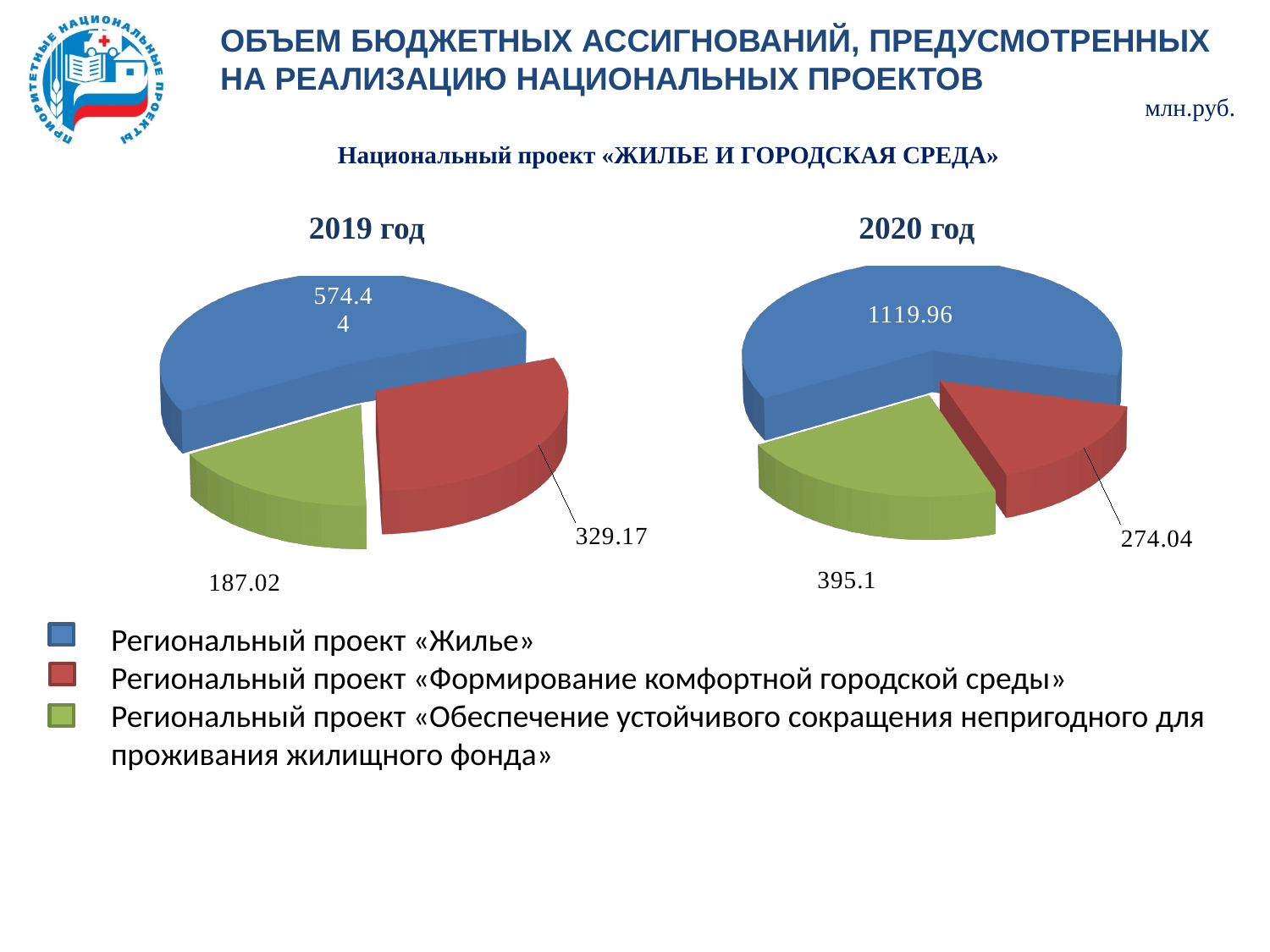
In the 2020 год pie chart, what is the value for Региональный проект «Жилье»? 1119.96 In the 2020 год pie chart, what is the value for Региональный проект «Формирование комфортной городской среды»? 274.04 In the 2020 год pie chart, which regional project has the largest value? Региональный проект «Жилье» How many slices does the 2020 год pie chart have? 3 In the 2019 год pie chart, what is the difference between the value for «Жилье» and the value for «Формирование комфортной городской среды»? 245.27 What kind of chart is used for the 2019 год and 2020 год data on the slide? Pie chart In the 2020 год pie chart, what is the value for Региональный проект «Обеспечение устойчивого сокращения непригодного для проживания жилищного фонда»? 395.1 In the 2019 год pie chart, which regional project has the smallest value? Региональный проект «Обеспечение устойчивого сокращения непригодного для проживания жилищного фонда» In the 2019 год pie chart, what is the value for Региональный проект «Обеспечение устойчивого сокращения непригодного для проживания жилищного фонда»? 187.02 In the 2019 год pie chart, what is the value for Региональный проект «Жилье»? 574.44 In the 2019 год pie chart, what is the value for Региональный проект «Формирование комфортной городской среды»? 329.17 In the 2020 год pie chart, which is larger: the value for «Формирование комфортной городской среды» or the value for «Обеспечение устойчивого сокращения непригодного для проживания жилищного фонда»? Региональный проект «Обеспечение устойчивого сокращения непригодного для проживания жилищного фонда»